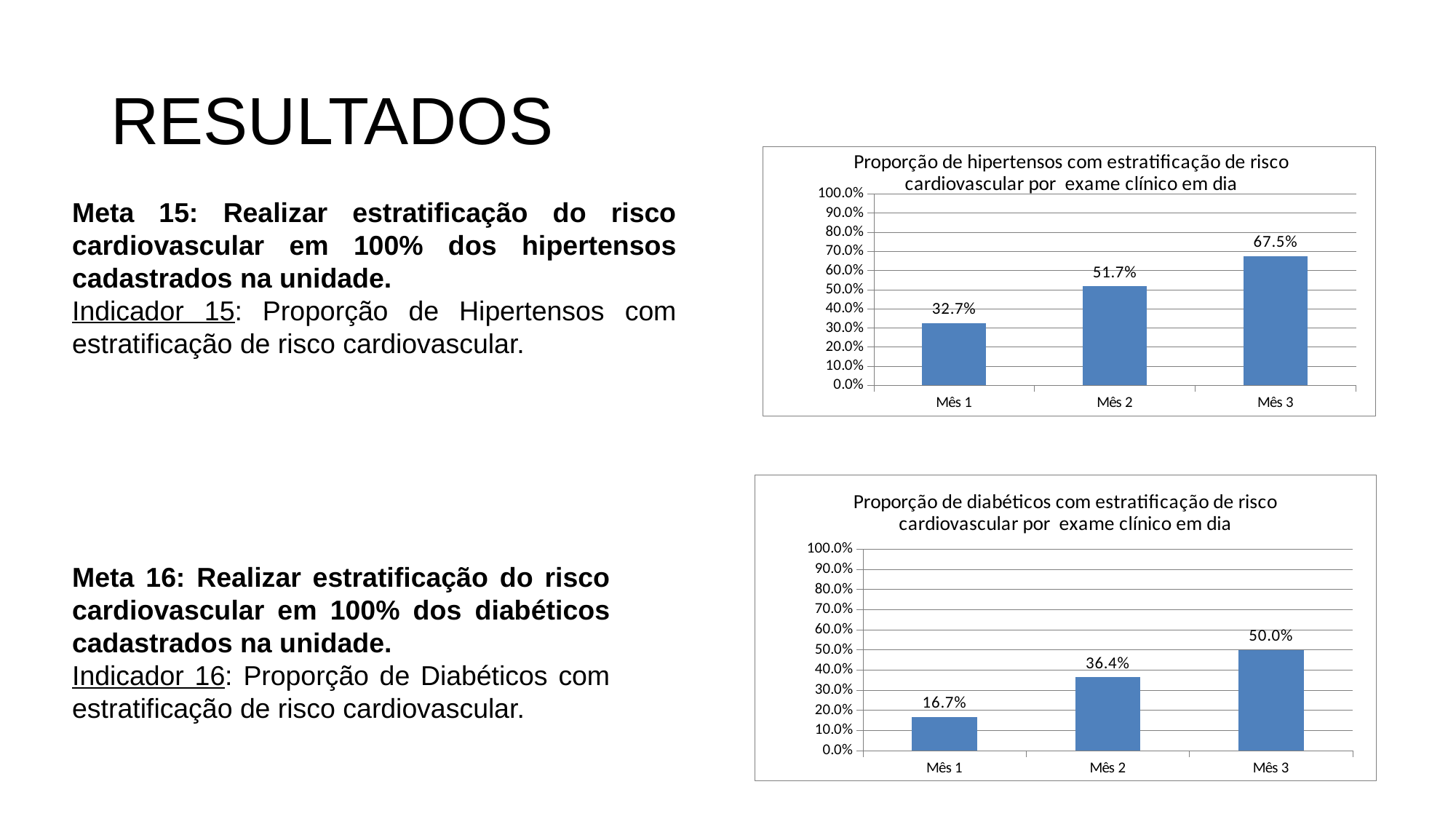
In the bottom chart (Proporção de diabéticos com estratificação de risco cardiovascular por exame clínico em dia), what is the value for Mês 1? 16.7% In the bottom chart (diabéticos), which is larger: the value for Mês 2 or Mês 3? Mês 3 In the bottom chart (diabéticos), what is the value for Mês 3? 50.0% What kind of chart is the bottom chart (diabéticos)? Bar chart In the top chart (hipertensos), what is the value for Mês 3? 67.5% In the top chart (hipertensos), do the values rise or fall from Mês 1 to Mês 3? Rise In the bottom chart (diabéticos), which month has the lowest value? Mês 1 In the top chart (hipertensos), which month has the highest value? Mês 3 In the top chart (Proporção de hipertensos com estratificação de risco cardiovascular por exame clínico em dia), what is the value for Mês 2? 51.7% How many categories (months) are shown in the top chart (hipertensos)? 3 In the bottom chart (diabéticos), what is the difference between the values for Mês 2 and Mês 1? 19.7% In the top chart (hipertensos), what is the difference between the values for Mês 3 and Mês 1? 34.8%